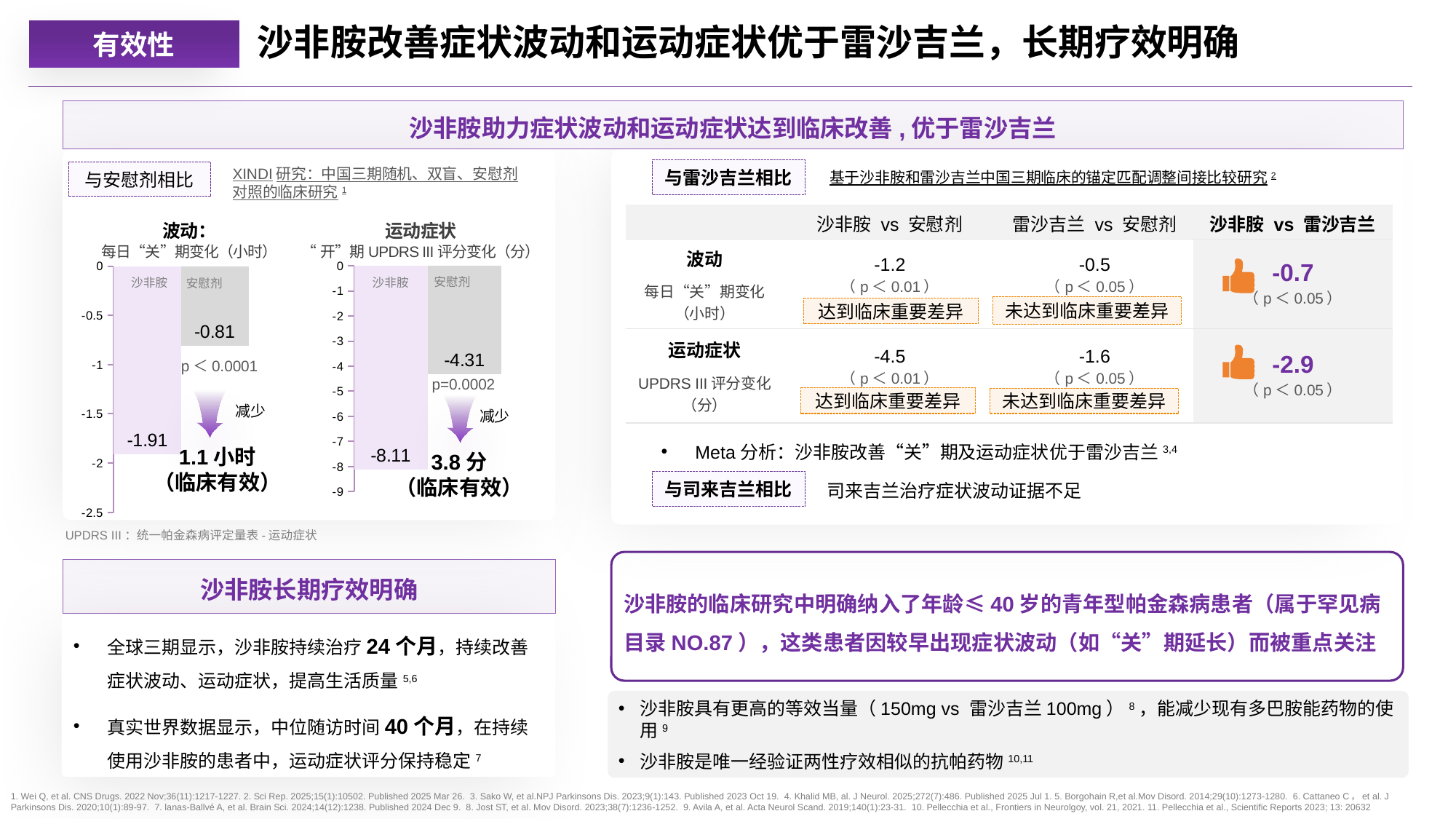
在“运动症状：“开”期 UPDRS III 评分变化（分）”图中，安慰剂的数值是多少？ -4.31 在“运动症状：“开”期 UPDRS III 评分变化（分）”图中，哪一组的数值最低？ 沙非胺 “波动：每日“关”期变化（小时）”图是什么类型的图表？ 柱状图（条形图） “波动：每日“关”期变化（小时）”图中标注的 p 值是多少？ p＜0.0001 在“波动：每日“关”期变化（小时）”图中，沙非胺的数值是大于还是小于 -1.5？ 小于 在“波动：每日“关”期变化（小时）”图中，沙非胺的数值是多少？ -1.91 “运动症状：“开”期 UPDRS III 评分变化（分）”图中有几个柱子？ 2 在“运动症状：“开”期 UPDRS III 评分变化（分）”图中，沙非胺与安慰剂的数值相差多少？ 3.8 分 在“波动：每日“关”期变化（小时）”图中，安慰剂的数值是多少？ -0.81 在“运动症状：“开”期 UPDRS III 评分变化（分）”图中，沙非胺的数值是多少？ -8.11 在“波动：每日“关”期变化（小时）”图中，哪一组的下降幅度更大？ 沙非胺 在“波动：每日“关”期变化（小时）”图中，沙非胺与安慰剂的数值相差多少？ 1.1 小时